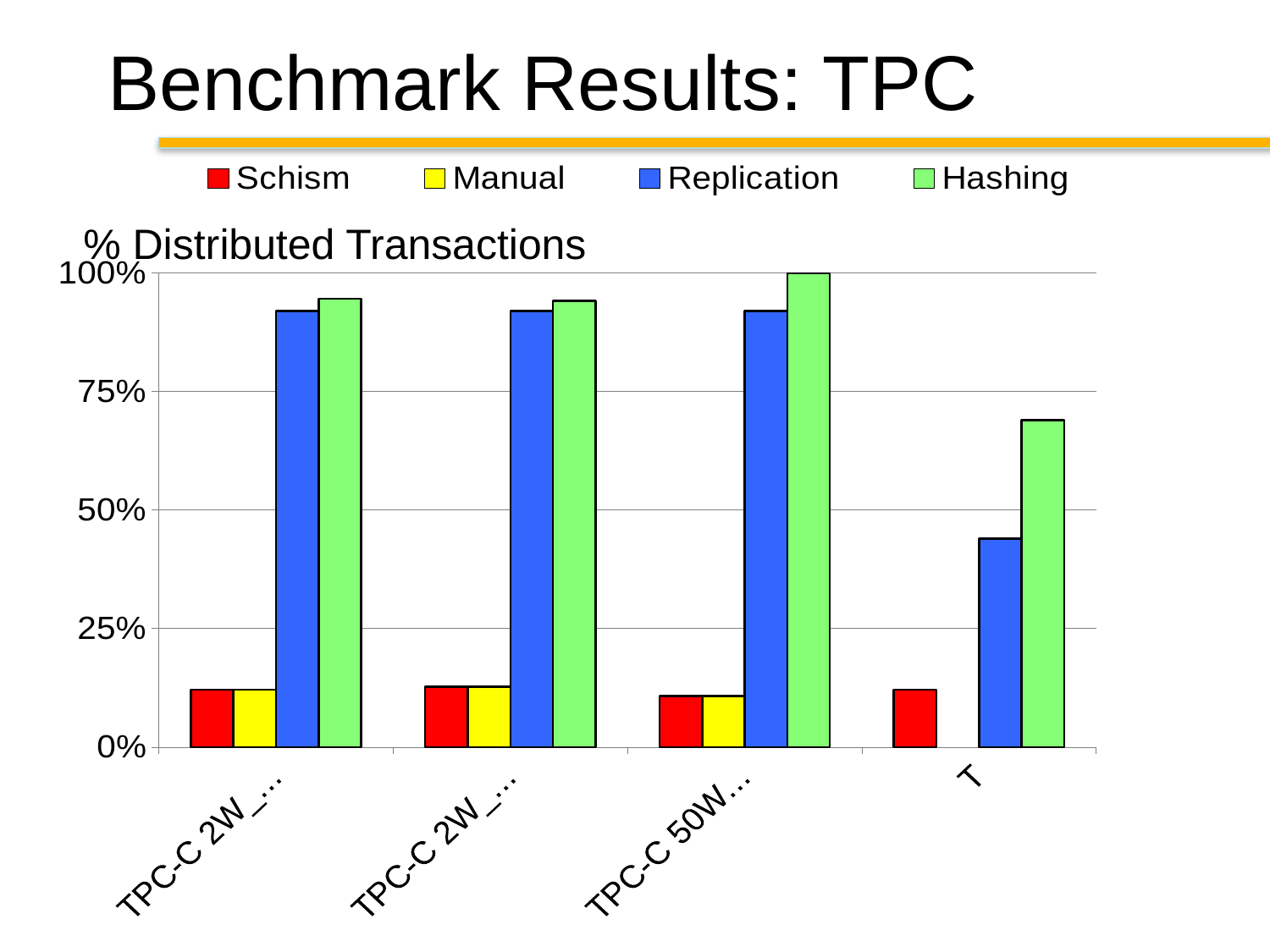
How many category groups are plotted along the x axis? 4 What is the title printed above the chart's plot area? % Distributed Transactions In the third category group (TPC-C 50W...), which is larger, Schism or Replication? Replication In the rightmost category group (labelled T), which is larger, Replication or Hashing? Hashing In the rightmost category group (labelled T), is the value for Hashing greater or less than 50%? greater Which series is shown in red in the legend? Schism How many series does the legend list? 4 In the third category group (TPC-C 50W...), is the value for Hashing greater or less than 75%? greater What kind of chart is shown on the slide? bar chart In the rightmost category group (labelled T), which series has the highest value? Hashing In the rightmost category group (labelled T), is the value for Replication greater or less than 50%? less